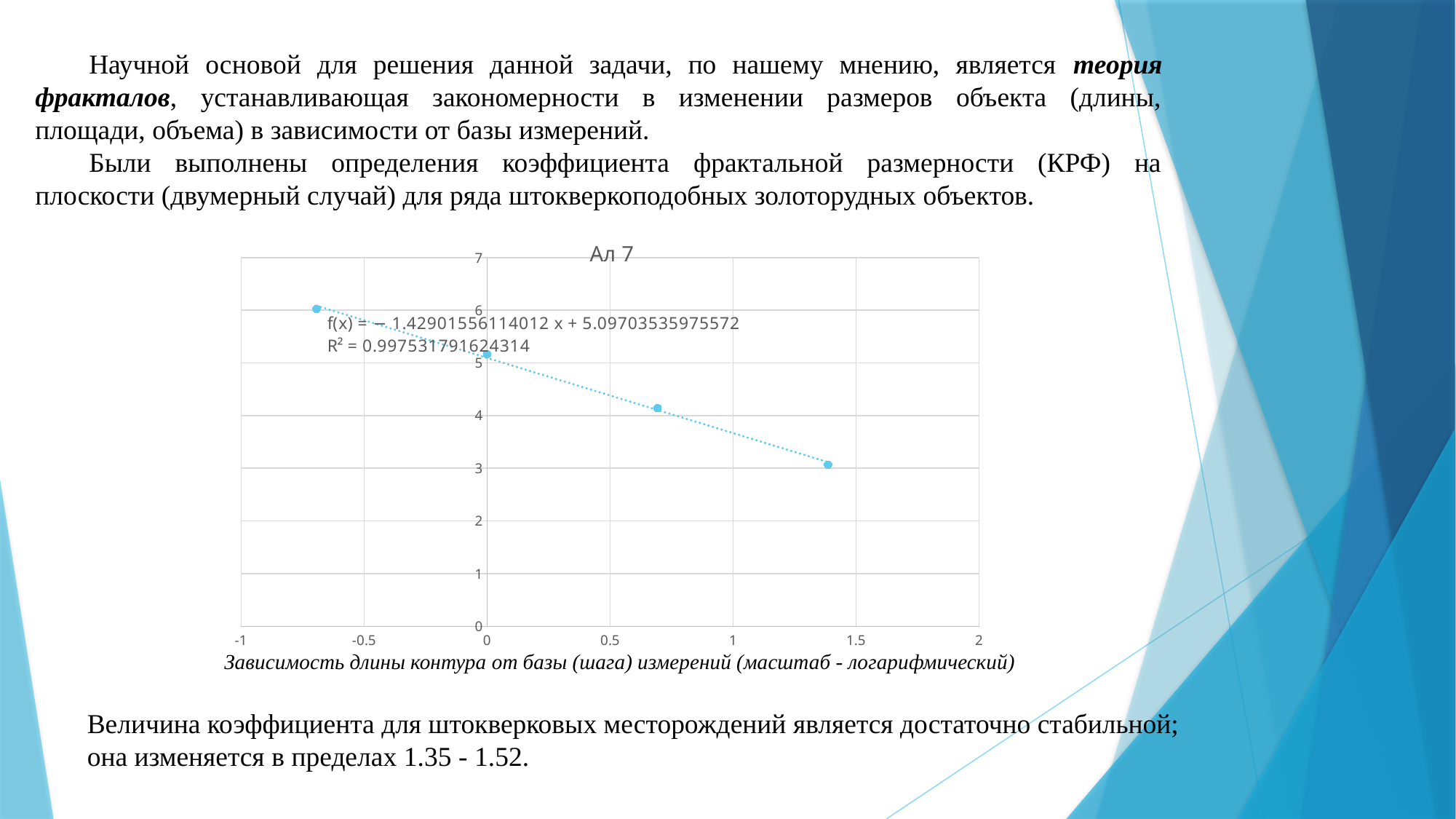
Which point has the highest y value: the leftmost or the rightmost? the leftmost What kind of chart is shown on the slide? scatter chart Do the plotted values rise or fall as x increases? fall What is the maximum value shown on the y axis? 7 What is the title of the chart? Ал 7 Is the y value of the rightmost point greater or less than 4? less Is the y value of the point near x = 0.7 greater or less than 5? less What is the R² value shown on the chart? 0.997531791624314 How many data points are plotted on the chart? 4 Is the y value of the point at x = 0 greater or less than 4? greater